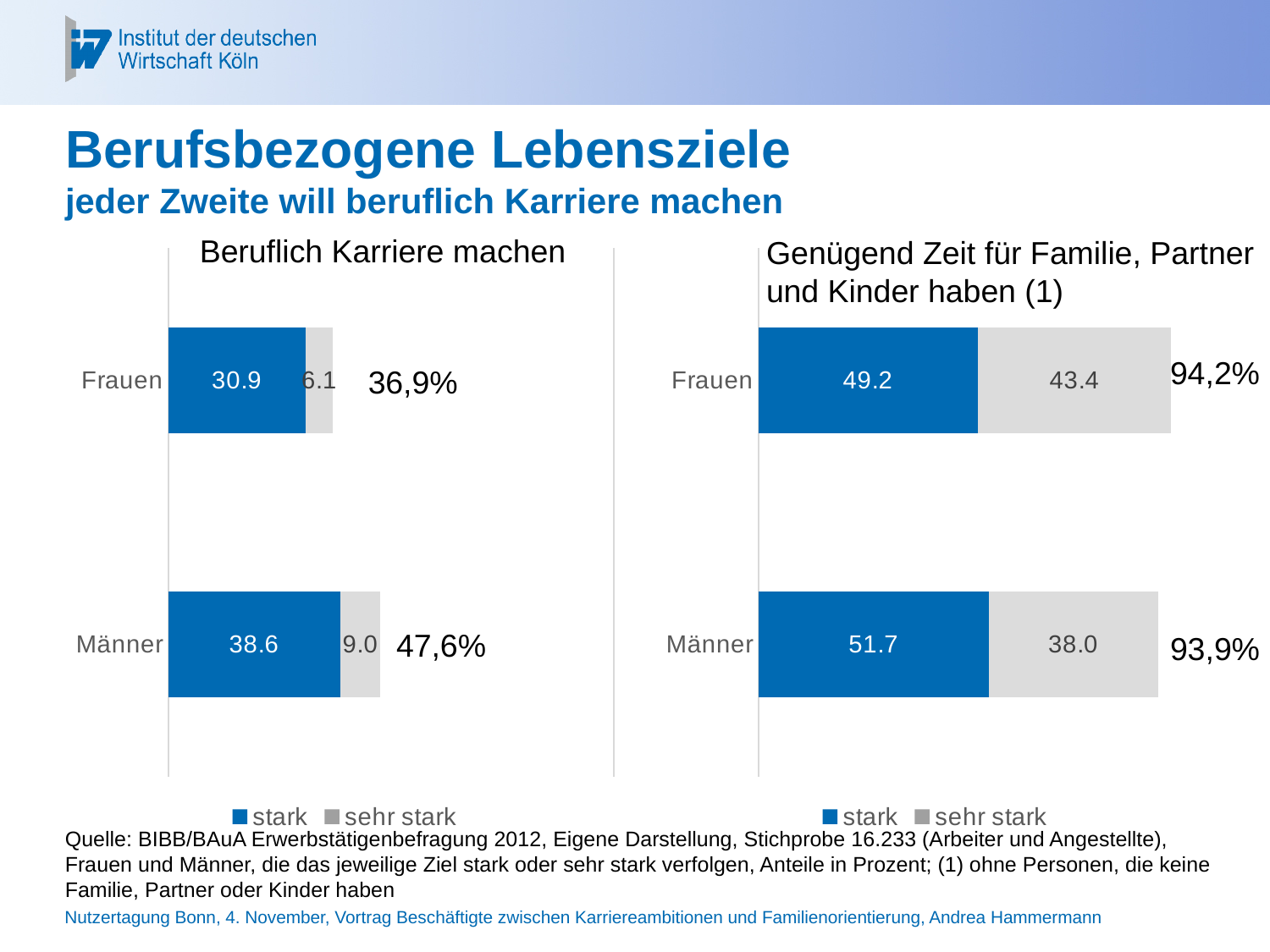
In the 'Genügend Zeit für Familie, Partner und Kinder haben (1)' chart, what is the difference between the 'sehr stark' values for Frauen and Männer? 5.4 In the 'Genügend Zeit für Familie, Partner und Kinder haben (1)' chart, what total percentage is shown next to the Frauen bar? 94,2% In the 'Beruflich Karriere machen' chart, what is the 'sehr stark' value for Männer? 9.0 In the 'Beruflich Karriere machen' chart, what total percentage is shown next to the Männer bar? 47,6% What kind of chart is the 'Genügend Zeit für Familie, Partner und Kinder haben (1)' chart? Stacked bar chart In the 'Genügend Zeit für Familie, Partner und Kinder haben (1)' chart, which group has the higher 'stark' value? Männer In the 'Beruflich Karriere machen' chart, what is the 'stark' value for Frauen? 30.9 In the 'Genügend Zeit für Familie, Partner und Kinder haben (1)' chart, what is the 'sehr stark' value for Frauen? 43.4 In the 'Beruflich Karriere machen' chart, which group has the larger 'sehr stark' value, Frauen or Männer? Männer In the 'Beruflich Karriere machen' chart, what is the difference between the 'stark' values for Männer and Frauen? 7.7 How many series does the legend of the 'Beruflich Karriere machen' chart list? 2 In the 'Genügend Zeit für Familie, Partner und Kinder haben (1)' chart, what is the 'stark' value for Männer? 51.7